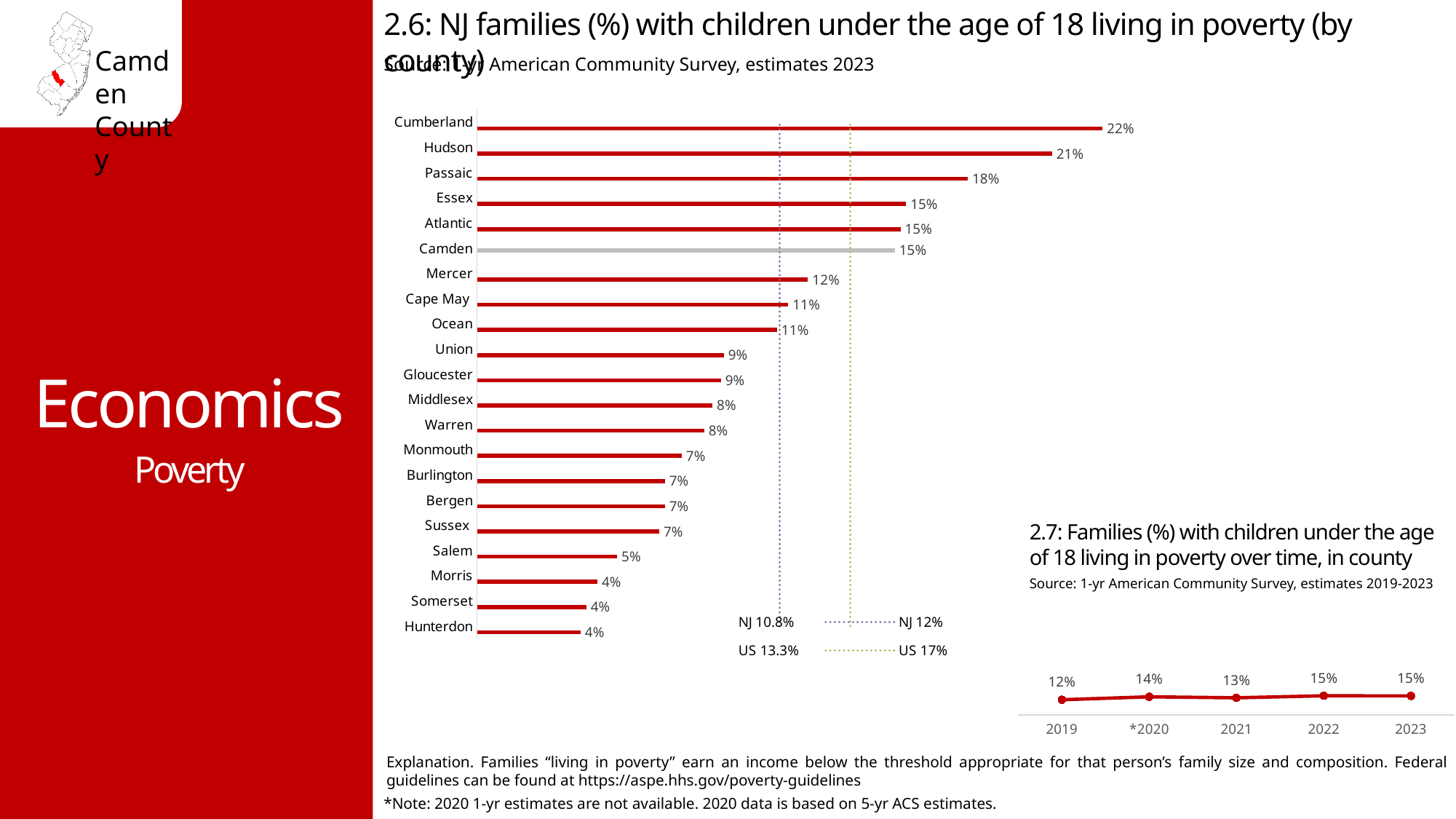
In chart 2.6, which county has the highest value? Cumberland In chart 2.6, which is larger, the value for Mercer or the value for Salem? Mercer In chart 2.6, what is the value for Camden? 15% In chart 2.6, what is the difference between the values for Camden and Hunterdon? 11% In chart 2.7, what is the value for 2019? 12% In chart 2.6, what is the value for Passaic? 18% In chart 2.7, what is the value for 2022? 15% What kind of chart is chart 2.7? Line chart In chart 2.6, what is the difference between the values for Cumberland and Hudson? 1% What kind of chart is chart 2.6? Bar chart In chart 2.6, how many counties are plotted? 21 In chart 2.7, how many years are plotted? 5